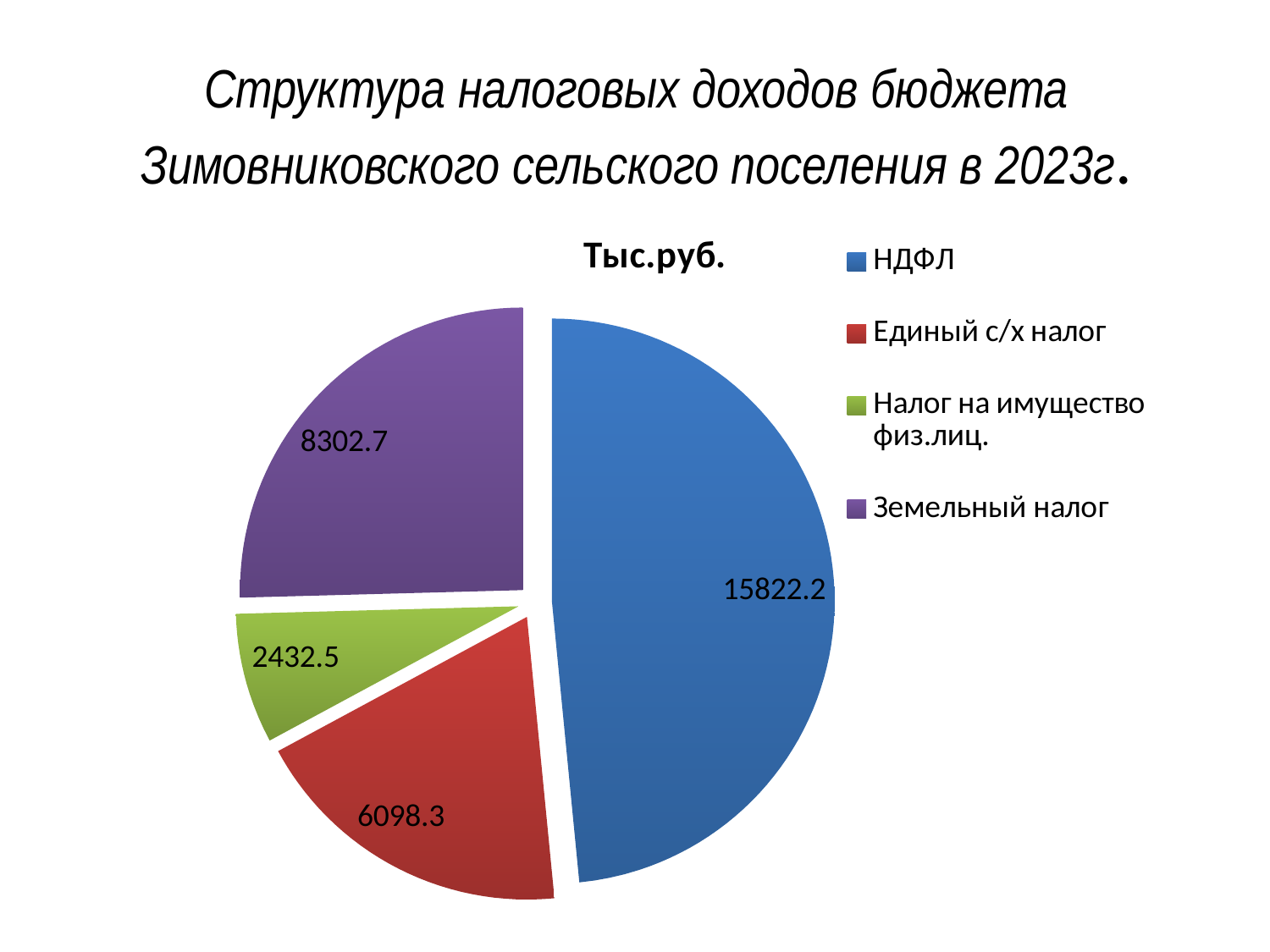
What is the value for Земельный налог? 8302.7 What unit is given in the chart title above the pie? Тыс.руб. What type of chart is shown on the slide? Pie chart What is the value for Налог на имущество физ.лиц.? 2432.5 Which is larger: Единый с/х налог or Земельный налог? Земельный налог Which category has the largest slice of the pie? НДФЛ What is the value for Единый с/х налог? 6098.3 Which category has the smallest slice of the pie? Налог на имущество физ.лиц. How many categories does the pie chart have? 4 What is the difference between the values for НДФЛ and Земельный налог? 7519.5 What is the value for НДФЛ? 15822.2 What is the difference between the values for Земельный налог and Единый с/х налог? 2204.4